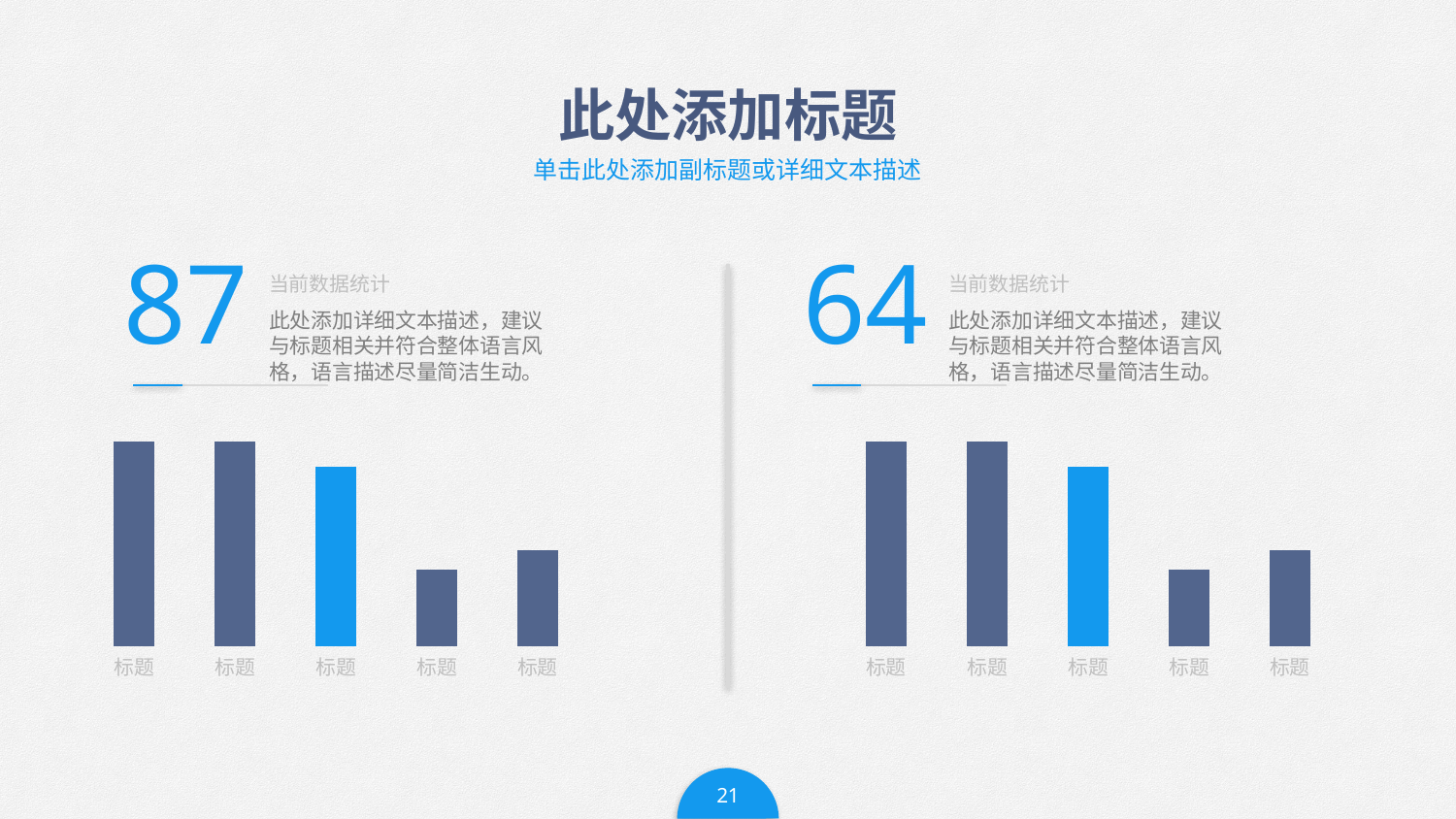
What large number is printed above the right chart? 64 How many bars does the left chart have? 5 What kind of chart is shown on the left side of the slide? bar chart In the left chart, which bar (by position from the left) is the shortest? the fourth bar How many bars does the right chart have? 5 What kind of chart is shown on the right side of the slide? bar chart In the right chart, which bar (by position from the left) is the shortest? the fourth bar What large number is printed above the left chart? 87 In the right chart, is the fourth bar taller or shorter than the fifth bar? shorter What label is printed under each bar in the right chart? 标题 In the left chart, which bar (by position from the left) is coloured light blue instead of dark grey-blue? the third bar In the left chart, is the third bar taller or shorter than the fifth bar? taller